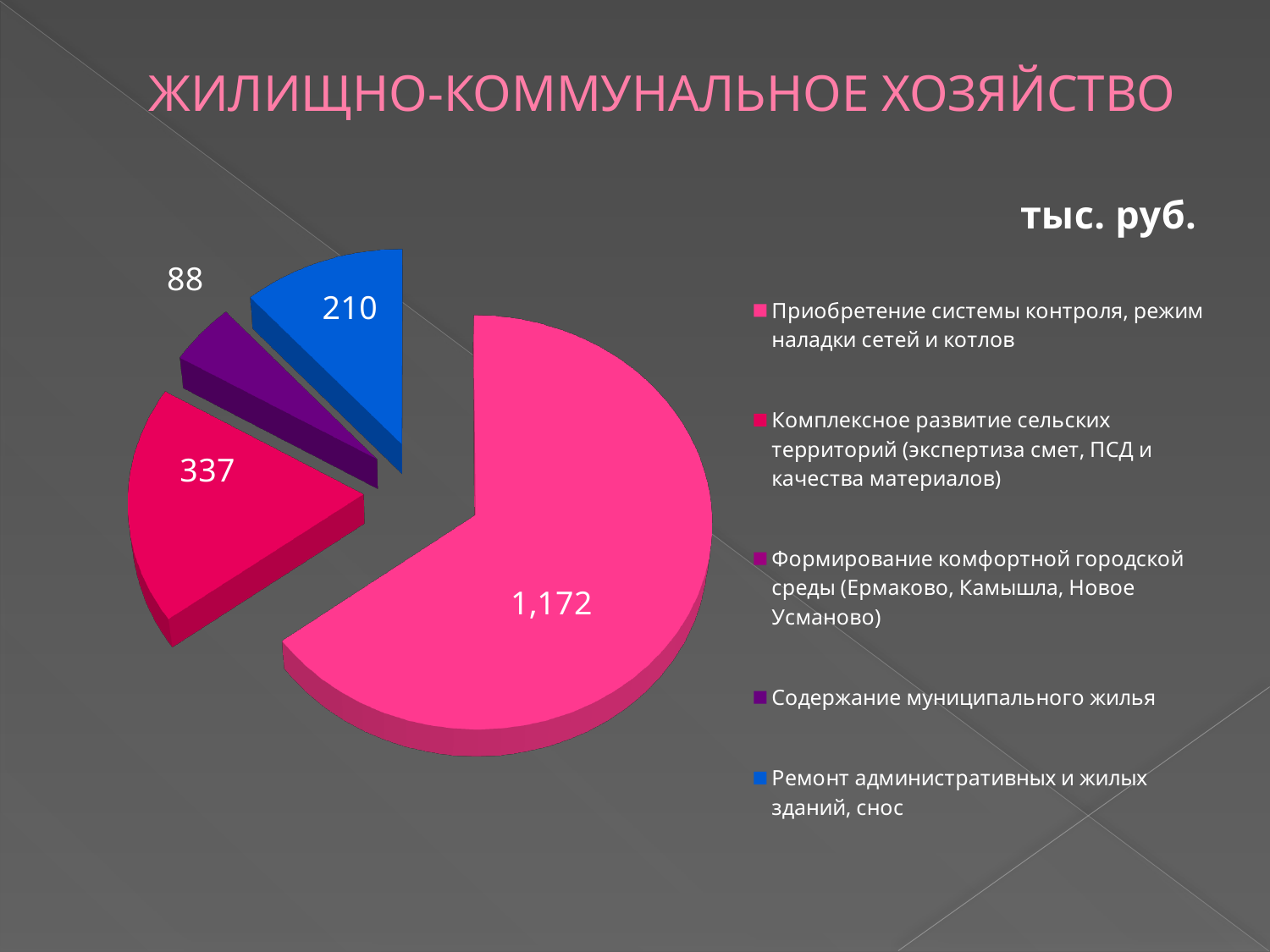
How many entries does the legend list? 5 Which is larger: the value for 'Ремонт административных и жилых зданий, снос' or the value for 'Комплексное развитие сельских территорий'? Комплексное развитие сельских территорий What is the value for 'Комплексное развитие сельских территорий (экспертиза смет, ПСД и качества материалов)'? 337 What is the difference between the largest slice (1,172) and the slice labelled 337? 835 In what units are the values on the chart given? тыс. руб. What is the smallest value labelled on the pie chart? 88 What is the value of the largest slice of the pie chart? 1,172 What type of chart is shown on the slide? Pie chart Which legend category corresponds to the largest slice (1,172)? Приобретение системы контроля, режим наладки сетей и котлов What is the value for 'Ремонт административных и жилых зданий, снос'? 210 How many data labels are shown on the pie chart? 4 What is the difference between the value for 'Комплексное развитие сельских территорий' (337) and 'Ремонт административных и жилых зданий, снос' (210)? 127